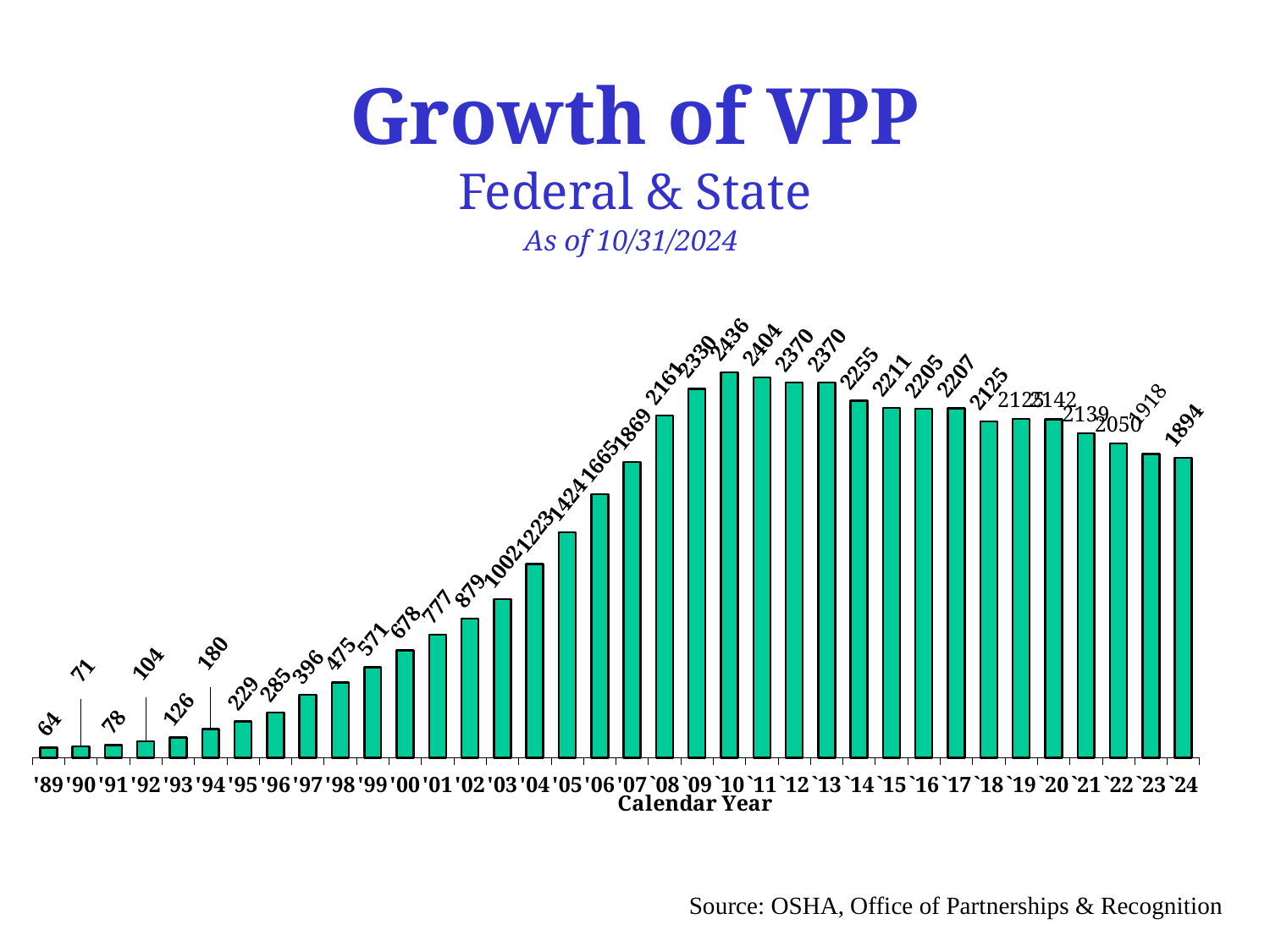
What is the value for '89? 64 What is the value for '00? 678 What is the value for `24? 1894 Which is larger, the value for `08 or the value for `09? `09 Which year has the highest value? `10 What is the difference between the values for `10 and `24? 542 What is the value for `10? 2436 Do the values rise or fall from '89 to `10? Rise What is the title of the x axis? Calendar Year Which year has the lowest value? '89 What kind of chart is shown on the slide? Bar chart How many bars are shown in the chart? 36